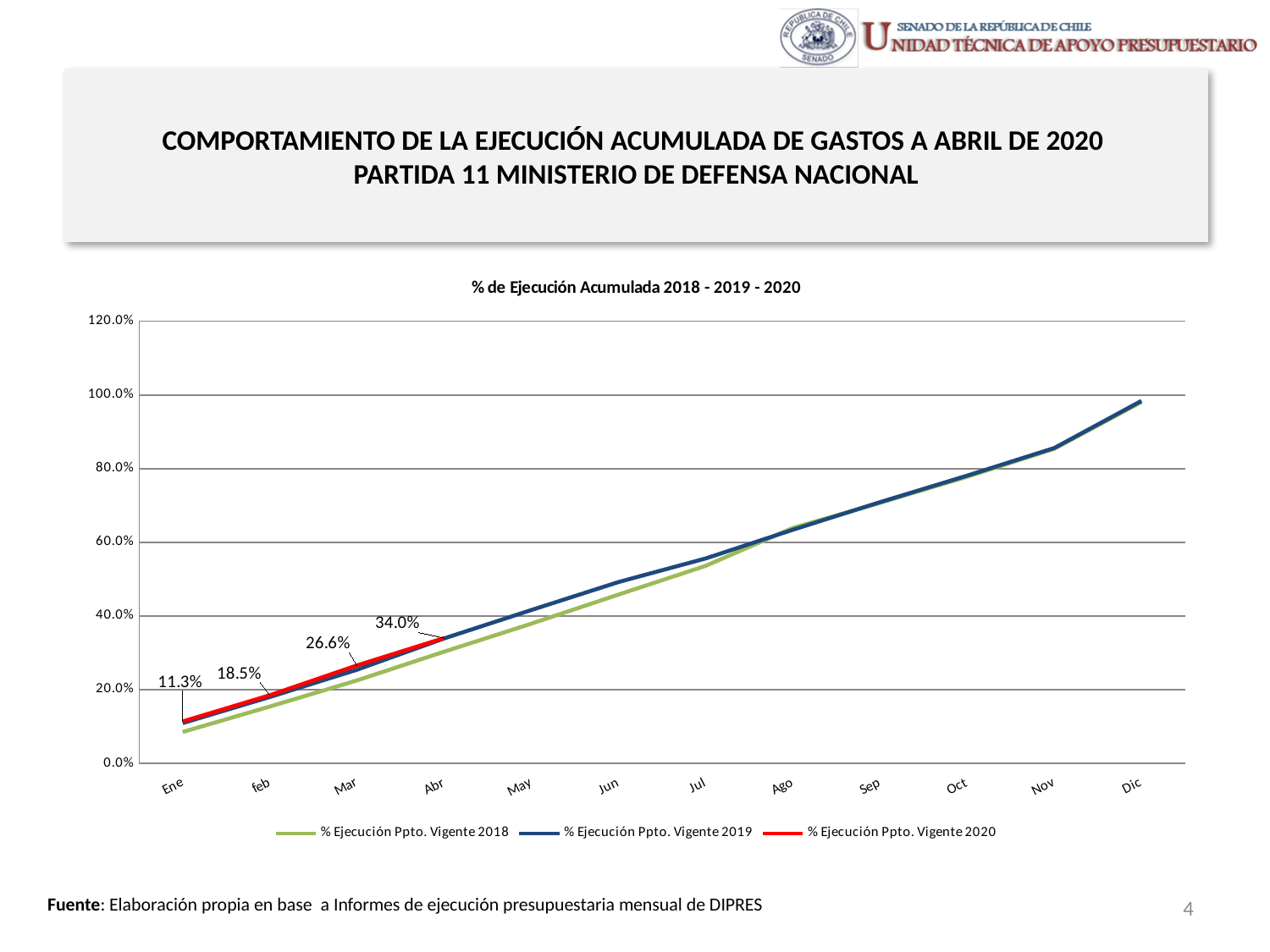
Is the value for % Ejecución Ppto. Vigente 2018 in Ene greater or less than 20.0%? less What is the title of the chart? % de Ejecución Acumulada 2018 - 2019 - 2020 What is the value of % Ejecución Ppto. Vigente 2020 in feb? 18.5% Is the value for % Ejecución Ppto. Vigente 2019 in Dic greater or less than 80.0%? greater Do the values of % Ejecución Ppto. Vigente 2019 rise or fall from Ene to Dic? rise How many months are shown on the x axis? 12 What is the value of % Ejecución Ppto. Vigente 2020 in Abr? 34.0% How many series does the legend list? 3 What is the value of % Ejecución Ppto. Vigente 2020 in Mar? 26.6% What kind of chart is shown on the slide? line chart By how many percentage points did % Ejecución Ppto. Vigente 2020 increase from Ene to Abr? 22.7 percentage points What is the value of % Ejecución Ppto. Vigente 2020 in Ene? 11.3%